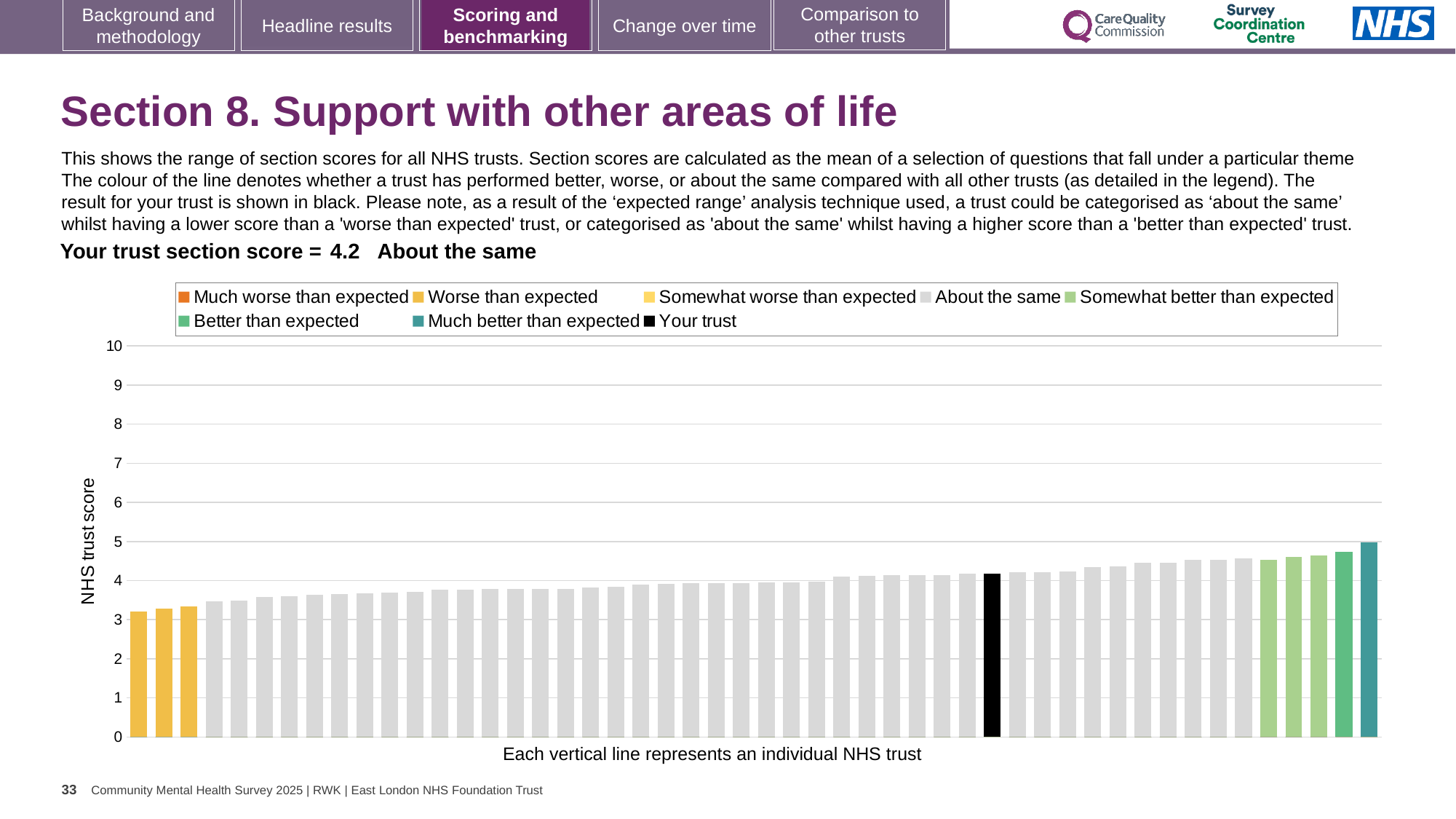
What is the section score for your trust? 4.2 Is the value of the black 'Your trust' bar greater or less than 4? greater Which legend category does the shortest bar belong to? Worse than expected Which is taller, the black 'Your trust' bar or the leftmost bar? the black 'Your trust' bar How many entries does the chart legend list? 8 What is the label on the vertical axis of the chart? NHS trust score Do the bar values rise or fall from left to right across the chart? rise How many bars are coloured as 'Worse than expected'? 3 What kind of chart is shown on the slide? bar chart Is the value of the rightmost bar greater or less than 4? greater Which legend category does the tallest bar belong to? Much better than expected Is the value of the leftmost bar greater or less than 4? less